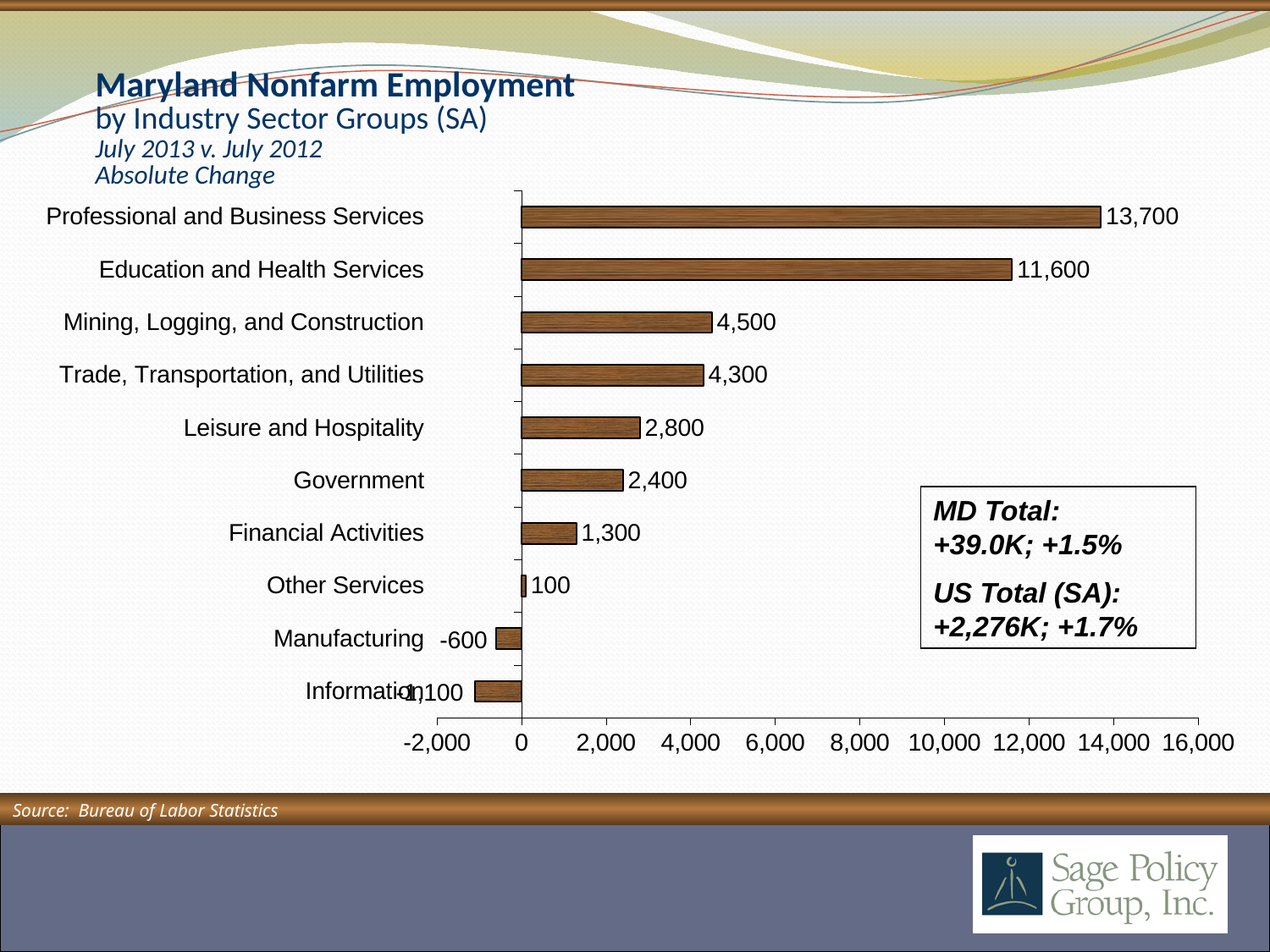
What is the value shown for Government? 2,400 What is the absolute change for Education and Health Services? 11,600 Which industry sector group has the highest absolute change? Professional and Business Services Which industry sector group has the lowest absolute change? Information How many industry sector groups are shown in the chart? 10 What is the absolute change for Professional and Business Services? 13,700 Which is larger, the value for Mining, Logging, and Construction or the value for Trade, Transportation, and Utilities? Mining, Logging, and Construction According to the text box on the chart, what is the MD Total change? +39.0K; +1.5% What is the difference between the values for Professional and Business Services and Education and Health Services? 2,100 What is the value shown for Manufacturing? -600 What is the difference between the values for Leisure and Hospitality and Financial Activities? 1,500 What kind of chart is shown on the slide? Bar chart